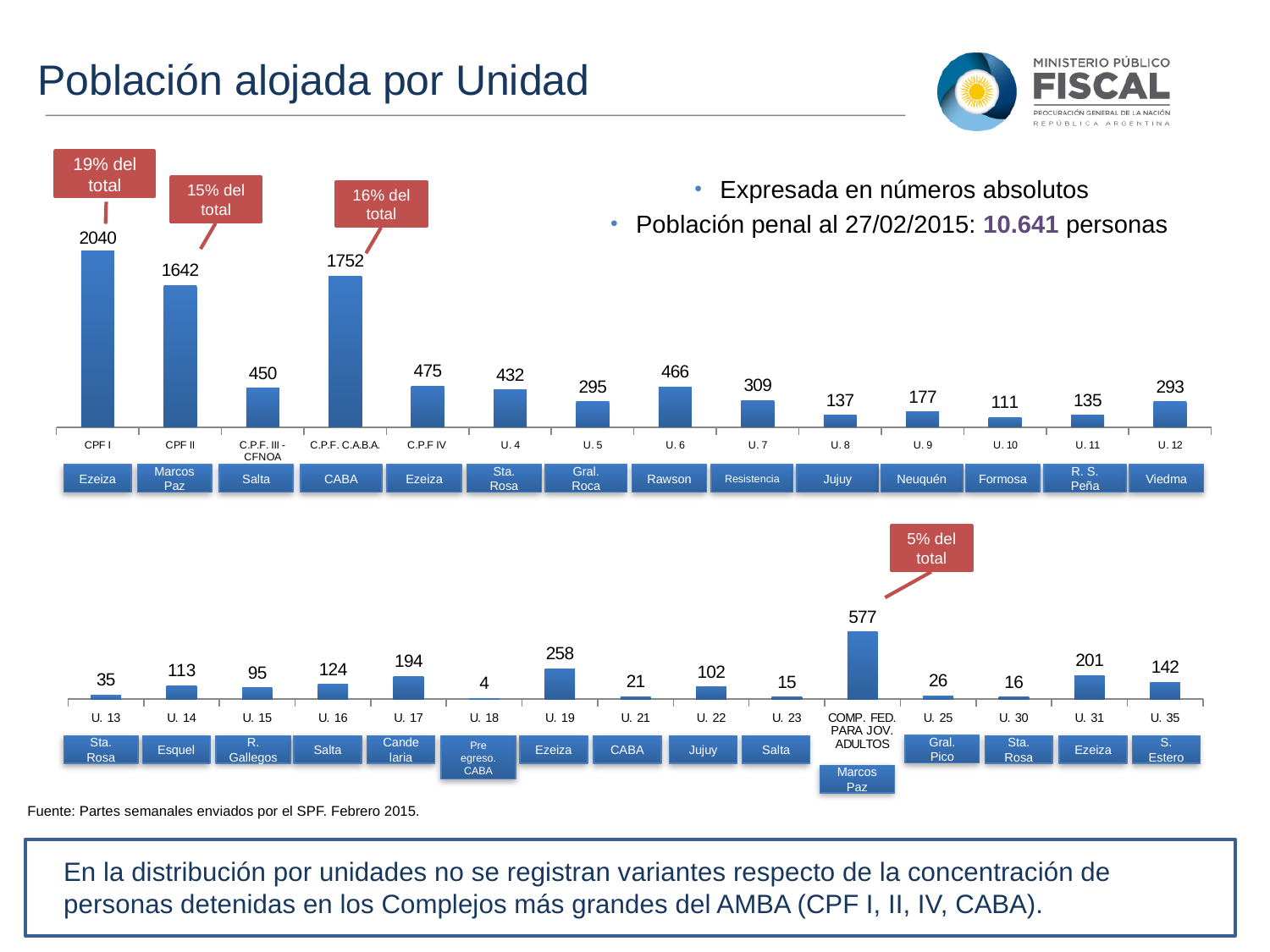
In the bottom chart, what is the difference between the values for U. 31 and U. 35? 59 In the top chart, which is larger, the value for U. 6 or the value for U. 4? U. 6 In the bottom chart, which unit has the highest value? COMP. FED. PARA JOV. ADULTOS In the bottom chart, what is the value for U. 19? 258 In the top chart, what is the difference between the values for CPF I and CPF II? 398 In the top chart, what is the value for C.P.F. C.A.B.A.? 1752 In the bottom chart, which unit has the lowest value? U. 18 What kind of chart is the bottom chart? Bar chart How many units are shown in the top chart? 14 In the top chart, which unit has the highest value? CPF I In the top chart, which unit has the lowest value? U. 10 In the top chart, what is the value for CPF I? 2040